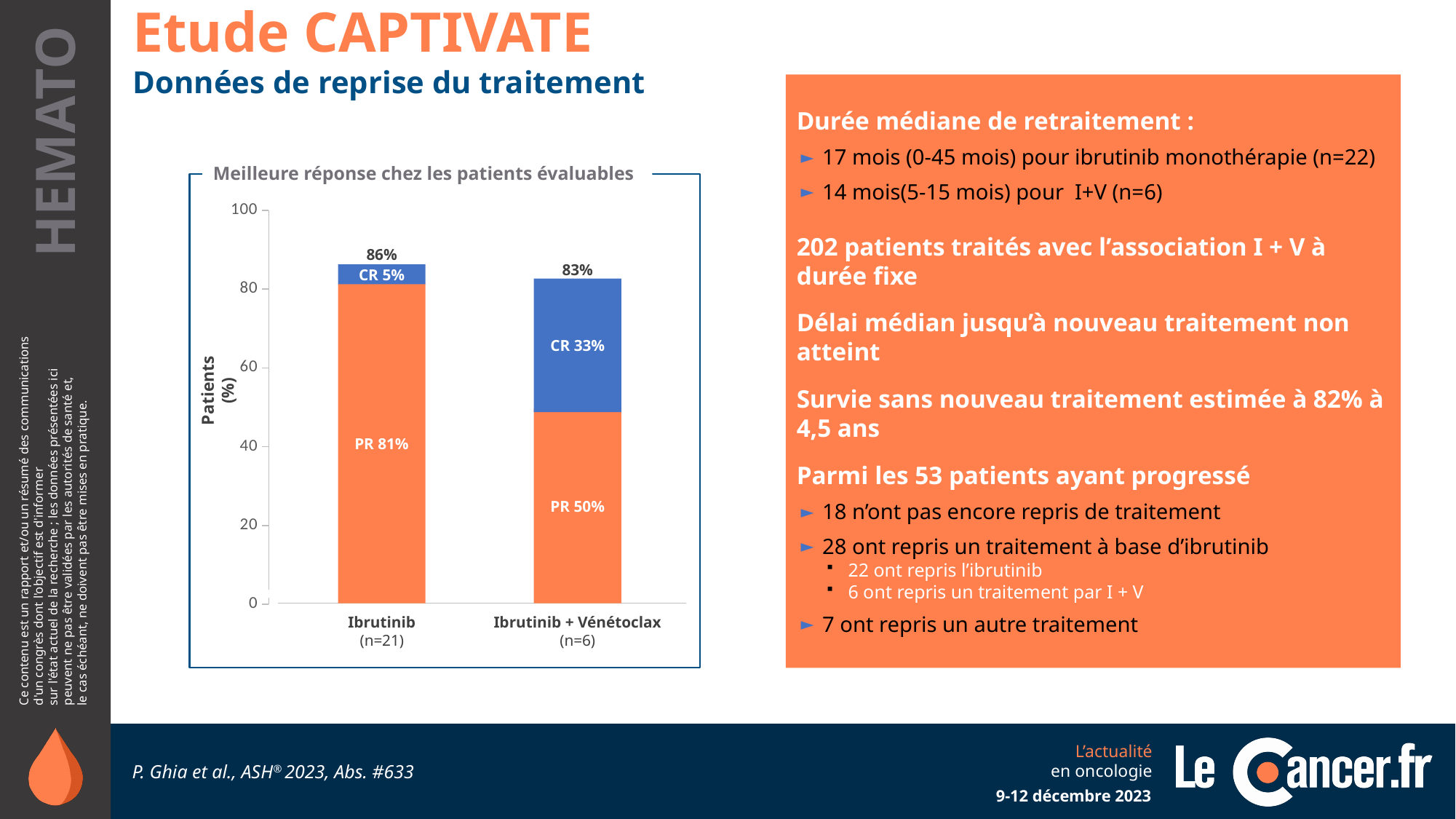
Which treatment group has the higher CR value, Ibrutinib or Ibrutinib + Vénétoclax? Ibrutinib + Vénétoclax How many treatment groups are shown on the x axis of the chart? 2 What is the PR value for Ibrutinib in the chart? 81% What is the PR value for Ibrutinib + Vénétoclax in the chart? 50% What is the CR value for Ibrutinib + Vénétoclax in the chart? 33% What kind of chart is shown on the slide? Stacked bar chart What is the title of the chart? Meilleure réponse chez les patients évaluables What is the difference in PR between Ibrutinib and Ibrutinib + Vénétoclax? 31 percentage points What is the total response rate shown above the Ibrutinib + Vénétoclax bar? 83% What is the total response rate shown above the Ibrutinib bar? 86% Which treatment group has the highest overall response rate in the chart? Ibrutinib What is the CR value for Ibrutinib in the chart? 5%